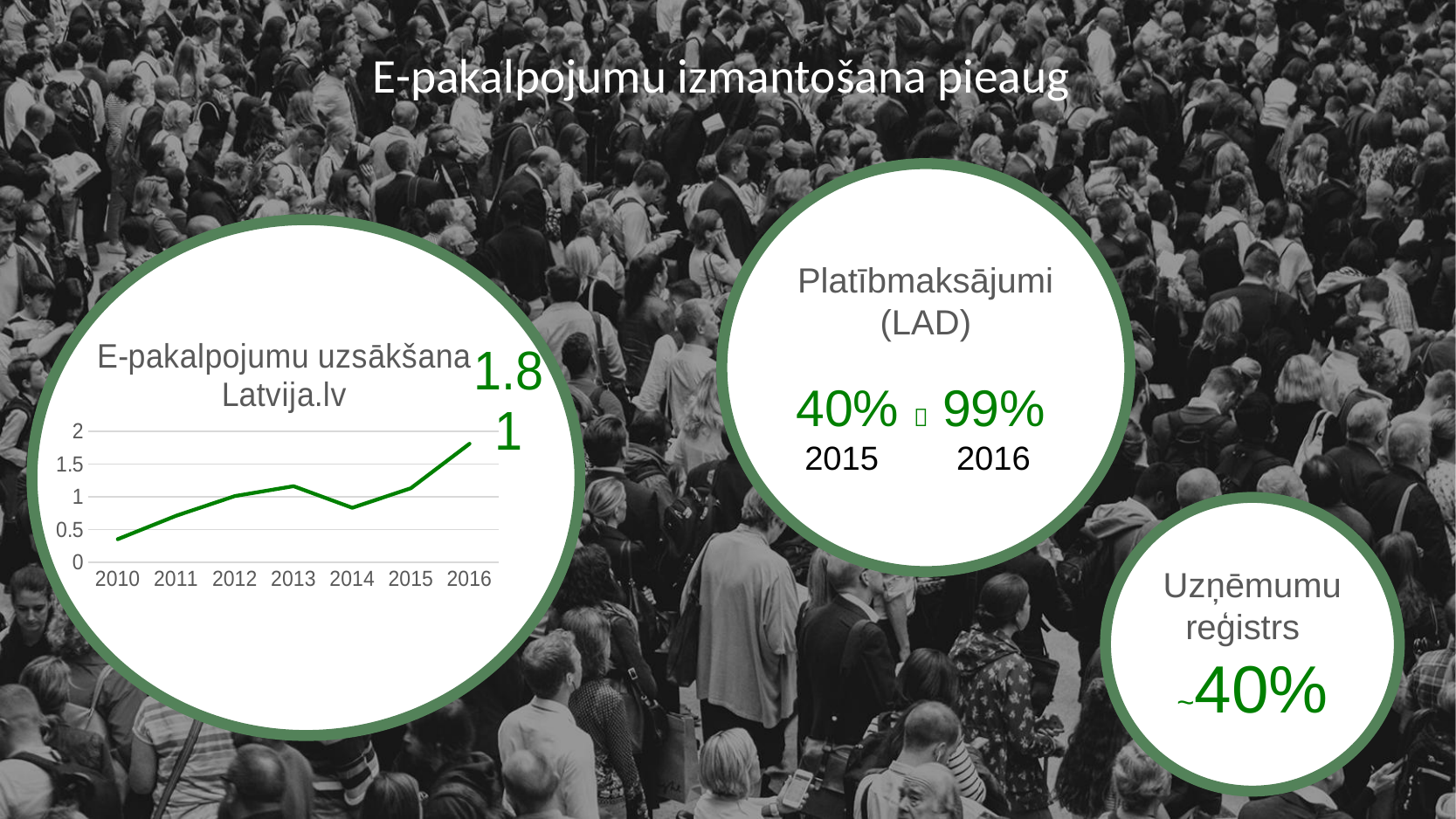
Which year has the larger value, 2011 or 2012? 2012 Which year has the highest value in the chart? 2016 What is the title of the chart on the slide? E-pakalpojumu uzsākšana Latvija.lv Which year has the larger value, 2013 or 2014? 2013 Which year has the lowest value in the chart? 2010 Is the value for 2013 greater or less than 1? greater What is the value shown for 2016 in the chart? 1.81 Is the value for 2010 greater or less than 0.5? less Is the value for 2014 greater or less than 1? less What kind of chart is shown on the slide? line chart How many years are plotted on the x axis of the chart? 7 Overall, do the values rise or fall from 2010 to 2016? rise